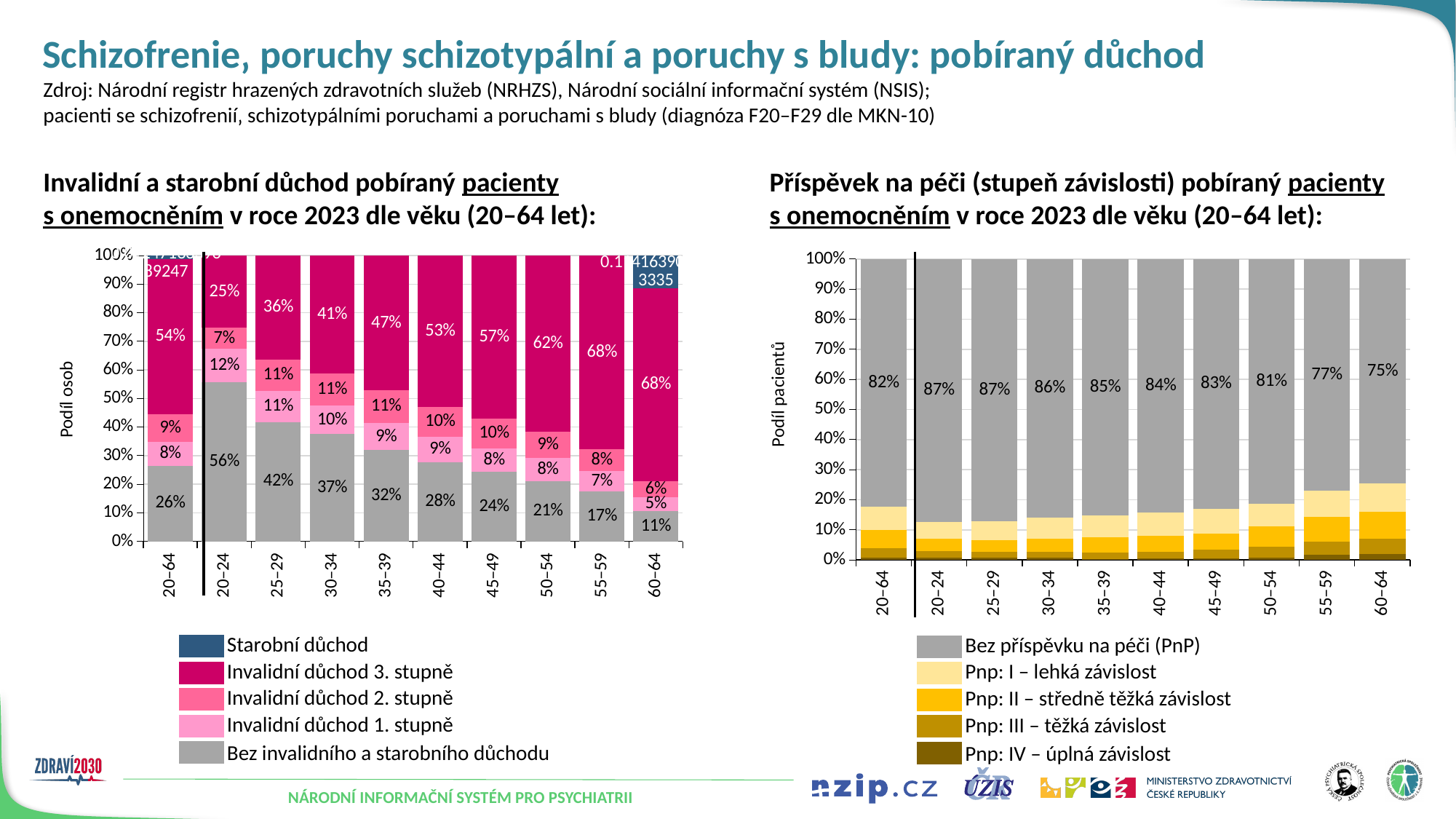
On the left chart (Invalidní a starobní důchod), does the share of 'Bez invalidního a starobního důchodu' rise or fall as age increases from 20–24 to 60–64? fall On the left chart (Invalidní a starobní důchod), what is the value for 'Invalidní důchod 1. stupně' in the 20–24 age group? 12% On the left chart (Invalidní a starobní důchod), which age group has the lowest share of 'Bez invalidního a starobního důchodu'? 60–64 On the left chart (Invalidní a starobní důchod), how many series does the legend list? 5 What type of chart is the right chart (Příspěvek na péči)? Stacked bar chart On the right chart (Příspěvek na péči), is the share of 'Bez příspěvku na péči (PnP)' larger in the 20–24 group or the 55–59 group? 20–24 On the right chart (Příspěvek na péči), which age group has the lowest share of 'Bez příspěvku na péči (PnP)'? 60–64 On the left chart (Invalidní a starobní důchod), what is the value for 'Bez invalidního a starobního důchodu' in the 20–24 age group? 56% On the left chart (Invalidní a starobní důchod), what is the difference between the 'Invalidní důchod 3. stupně' share in the 60–64 group and in the 20–24 group? 43 percentage points On the left chart (Invalidní a starobní důchod), what share of the 50–54 age group receives 'Invalidní důchod 3. stupně'? 62% On the right chart (Příspěvek na péči), what is the value for 'Bez příspěvku na péči (PnP)' in the 60–64 age group? 75% On the right chart (Příspěvek na péči), how many age categories are shown on the x axis? 10